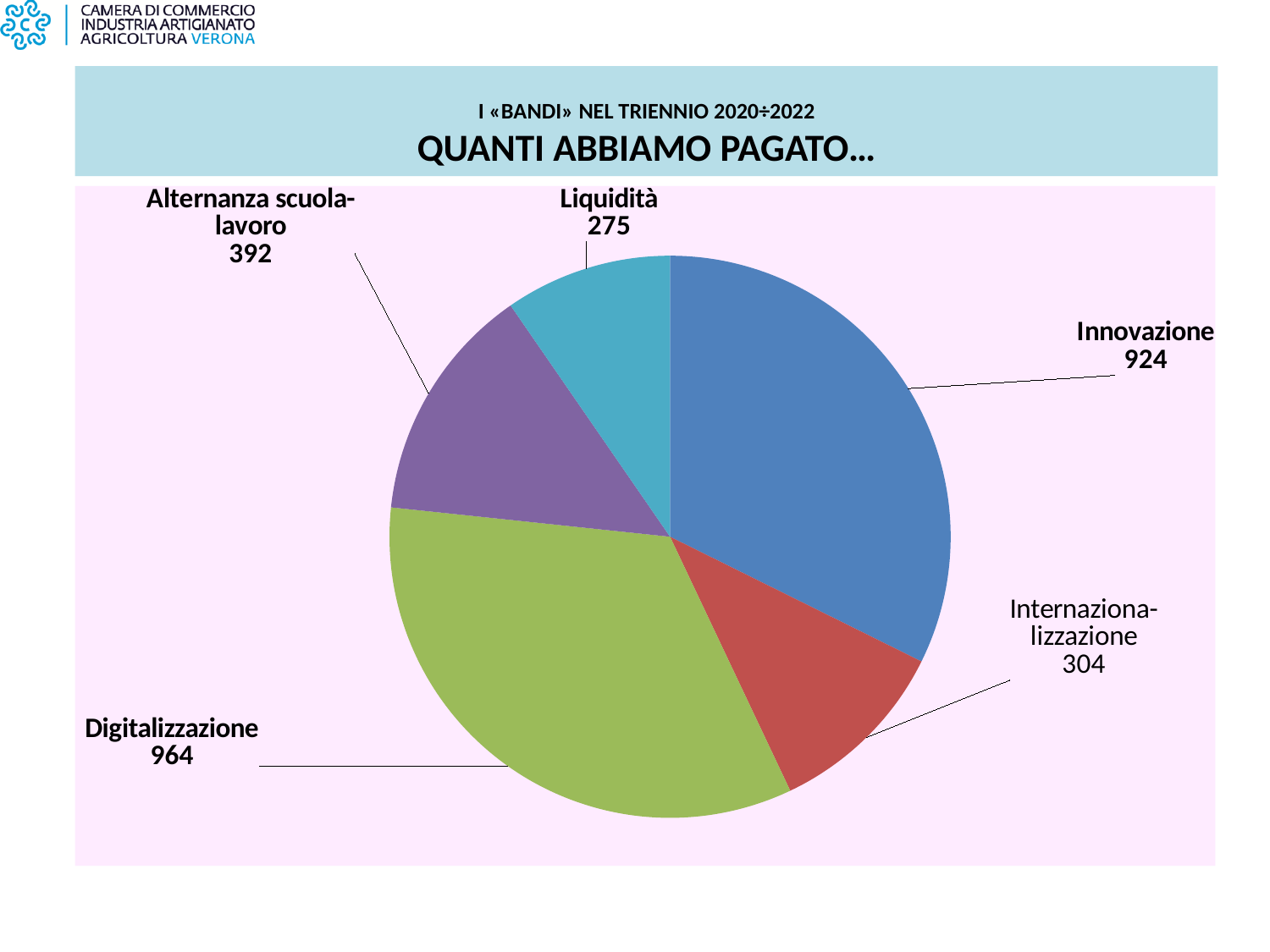
What is the value for Liquidità? 275 Which category has the lowest value? Liquidità What share of the pie does Digitalizzazione represent, to the nearest whole percent? 34% What is the difference between the values for Digitalizzazione and Innovazione? 40 Which category has the highest value? Digitalizzazione What kind of chart is shown on the slide? pie chart What is the value for Internazionalizzazione? 304 What is the value for Alternanza scuola-lavoro? 392 Which is larger, the value for Alternanza scuola-lavoro or the value for Internazionalizzazione? Alternanza scuola-lavoro What is the title of the chart? QUANTI ABBIAMO PAGATO… How many slices does the pie chart have? 5 What is the value for Innovazione? 924